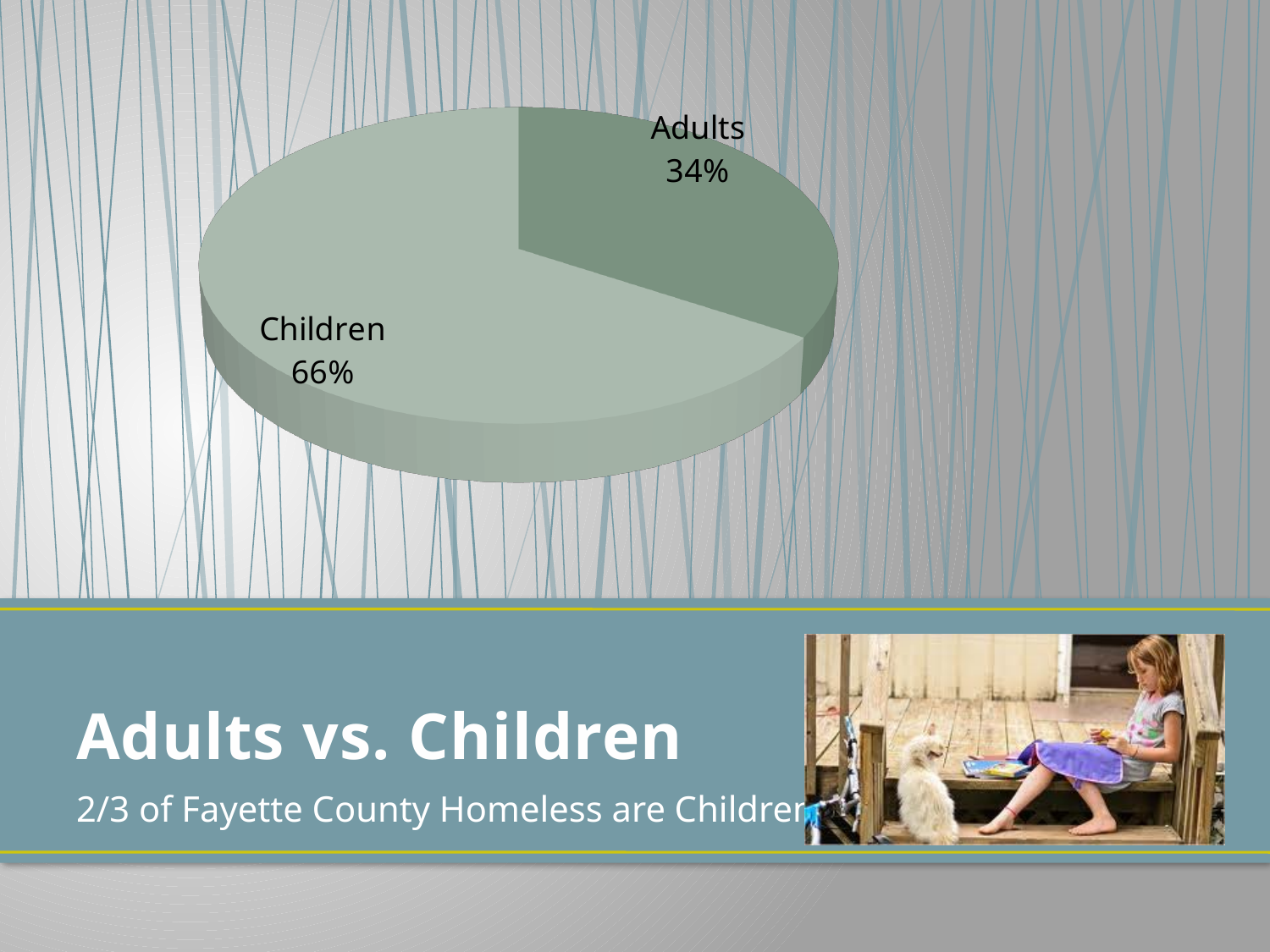
What share of the pie is labelled Children? 66% What is the title text shown below the chart on the slide? Adults vs. Children Is the share for Children greater or less than 50%? greater Is the share for Adults greater or less than 50%? less What is the difference in percentage points between the Children slice and the Adults slice? 32 How many slices does the pie chart have? 2 What share of the pie is labelled Adults? 34% What do the two slices of the pie add up to? 100% What kind of chart is shown on the slide? pie chart Which slice of the pie is the largest? Children Which slice of the pie is the smallest? Adults Which slice is larger, Adults or Children? Children